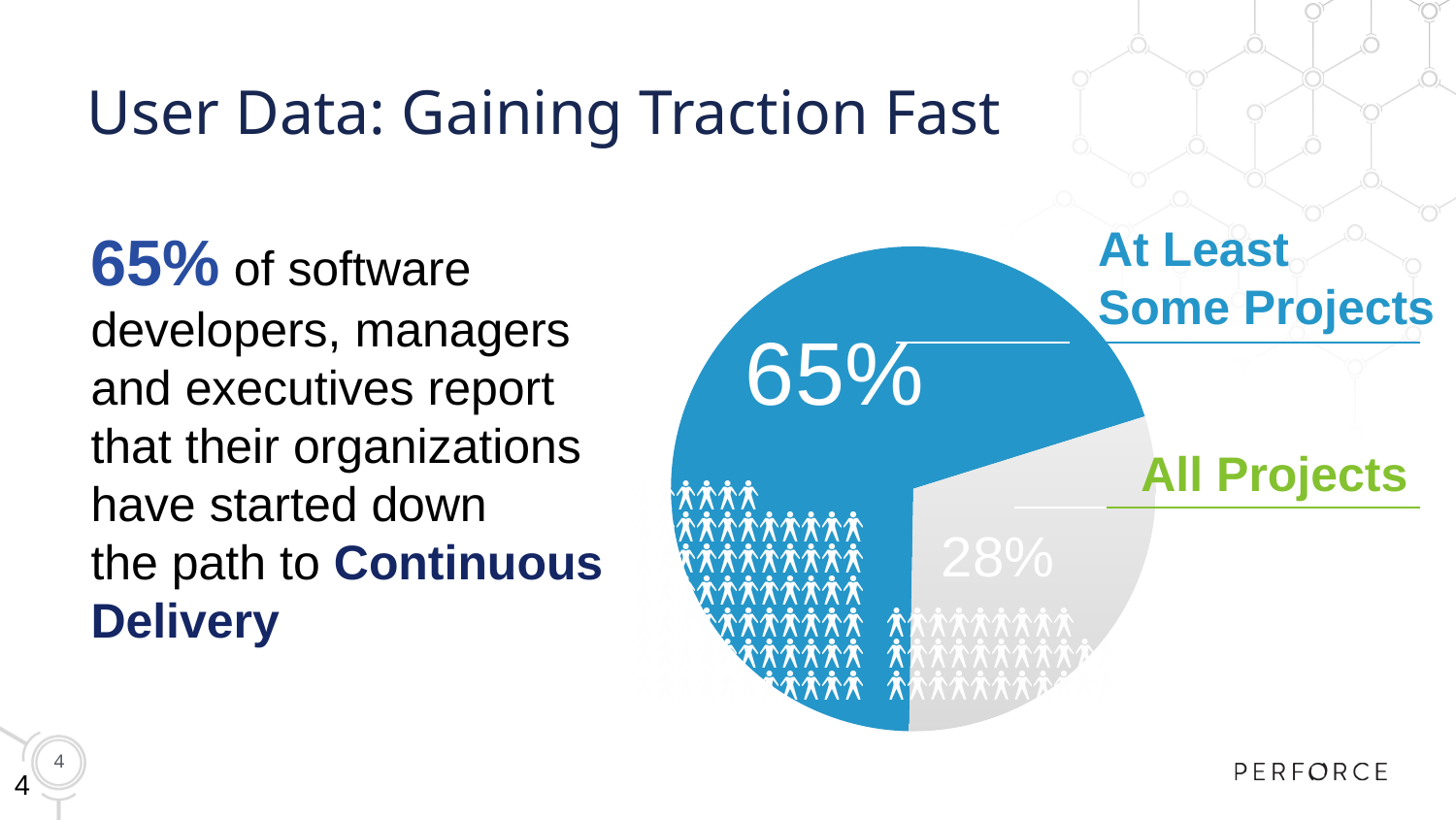
What kind of chart is shown on the slide? pie chart What colour is the "At Least Some Projects" slice of the pie chart? blue Which is larger, the "At Least Some Projects" slice or the "All Projects" slice? At Least Some Projects What percentage is shown for the "All Projects" slice? 28% Which labeled slice of the pie chart is the smallest? All Projects What percentage is shown for the "At Least Some Projects" slice? 65% What is the title of the slide containing the pie chart? User Data: Gaining Traction Fast What is the difference in percentage points between the "At Least Some Projects" slice and the "All Projects" slice? 37 percentage points Which slice of the pie chart is the largest? At Least Some Projects How many labeled slices does the pie chart have? 2